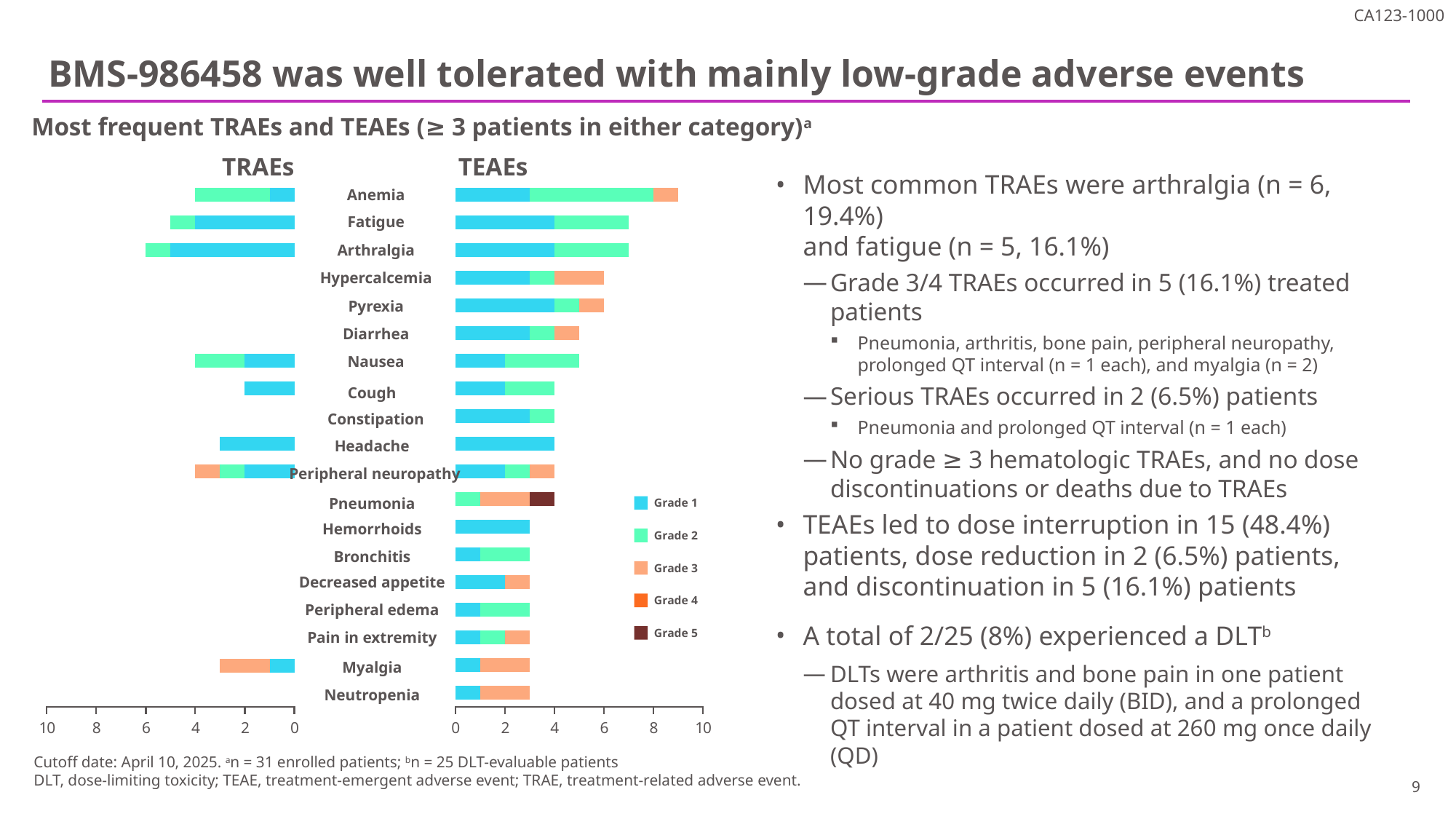
How many adverse event categories are listed on the chart? 19 How many grade series does the legend of the adverse event chart list? 5 On the TEAEs side of the chart, is the value for anemia greater or less than 8? greater On the TEAEs side of the chart, which adverse event has the highest number of patients? Anemia What kind of chart is used to show the TRAEs and TEAEs on this slide? Bar chart On the TRAEs side of the chart, how many patients had cough? 2 On the TEAEs side of the chart, which is larger, the bar for anemia or the bar for fatigue? Anemia On the TRAEs side of the chart, which adverse event has the highest number of patients? Arthralgia Which colour does the legend use for Grade 5 events? Dark red On the TEAEs side of the chart, is the value for hemorrhoids greater or less than 4? less On the TRAEs side of the chart, how many patients had arthralgia? 6